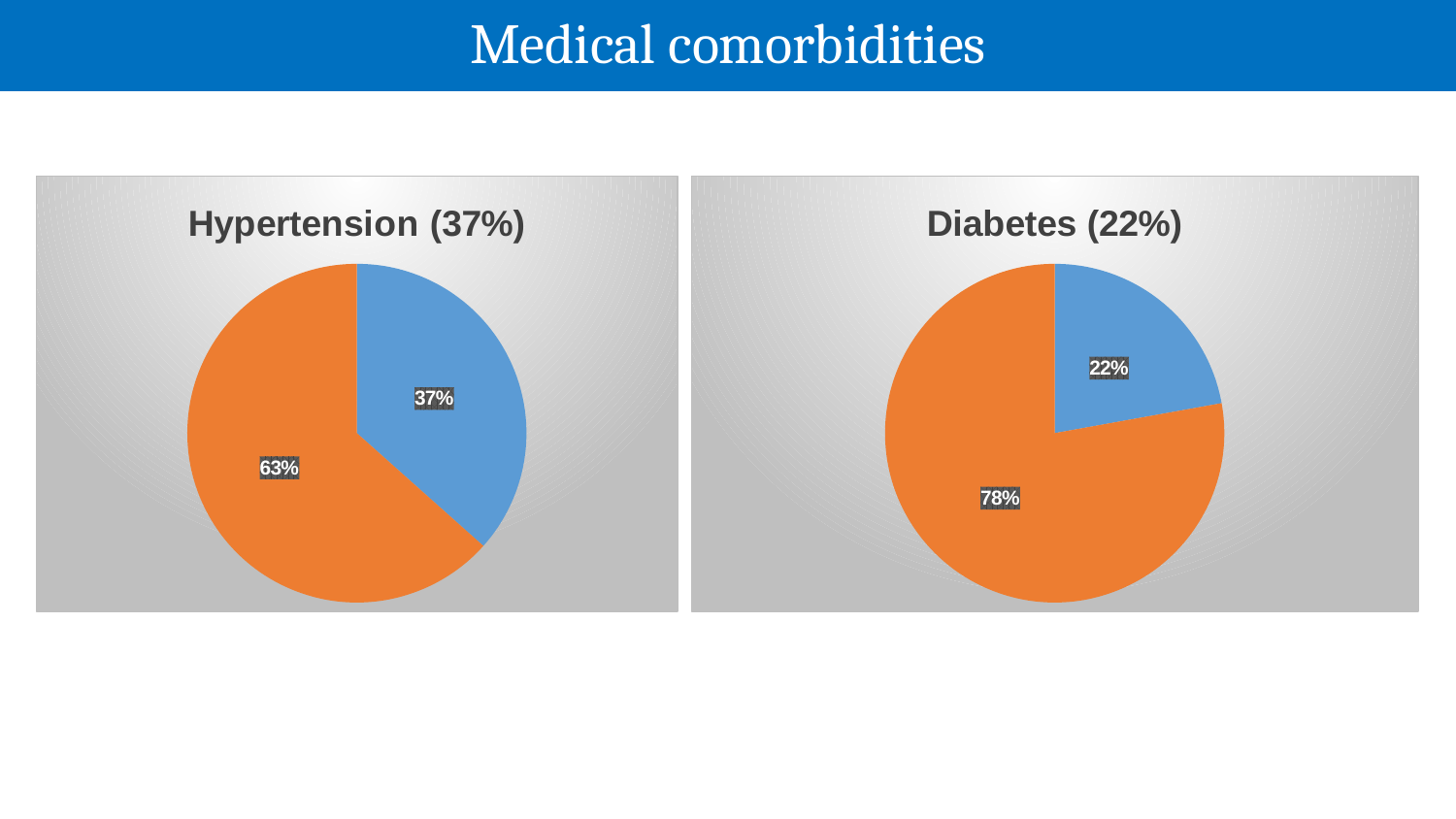
In the 'Diabetes (22%)' chart, what percentage is shown on the blue slice? 22% In the 'Hypertension (37%)' chart, what percentage is shown on the blue slice? 37% What is the title of the pie chart on the right of the slide? Diabetes (22%) In the 'Hypertension (37%)' chart, what is the difference between the orange slice and the blue slice? 26% In the 'Diabetes (22%)' chart, what percentage is shown on the orange slice? 78% Which chart has the larger blue slice, 'Hypertension (37%)' or 'Diabetes (22%)'? Hypertension (37%) What kind of chart is the 'Hypertension (37%)' chart? pie chart How many pie charts are shown on the slide? 2 How many slices does the 'Diabetes (22%)' pie chart have? 2 In the 'Hypertension (37%)' chart, what percentage is shown on the orange slice? 63% In the 'Hypertension (37%)' chart, which slice is larger, the blue or the orange one? orange In the 'Diabetes (22%)' chart, what is the difference between the orange slice and the blue slice? 56%